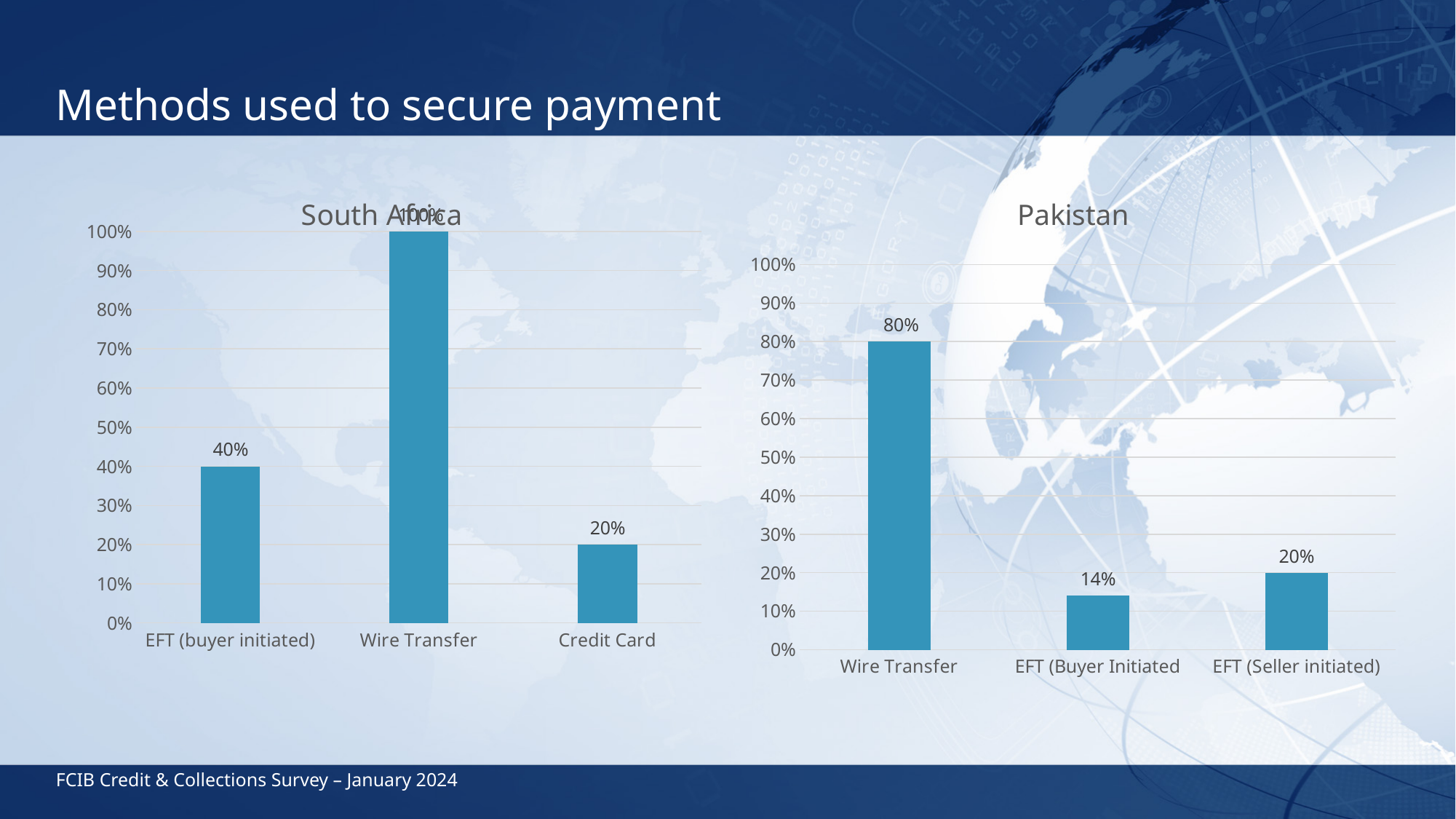
In the Pakistan chart, what is the value for EFT (Buyer Initiated)? 14% In the South Africa chart, what is the difference between EFT (buyer initiated) and Credit Card? 20% In the Pakistan chart, what is the difference between Wire Transfer and EFT (Seller initiated)? 60% In the Pakistan chart, which category has the lowest value? EFT (Buyer Initiated) In the South Africa chart, which category has the lowest value? Credit Card In the South Africa chart, which category has the highest value? Wire Transfer In the South Africa chart, what is the value for EFT (buyer initiated)? 40% In the Pakistan chart, what is the value for Wire Transfer? 80% In the Pakistan chart, which is larger: EFT (Buyer Initiated) or EFT (Seller initiated)? EFT (Seller initiated) In the South Africa chart, what is the value for Credit Card? 20% How many categories does the Pakistan chart show? 3 In the Pakistan chart, what is the value for EFT (Seller initiated)? 20%